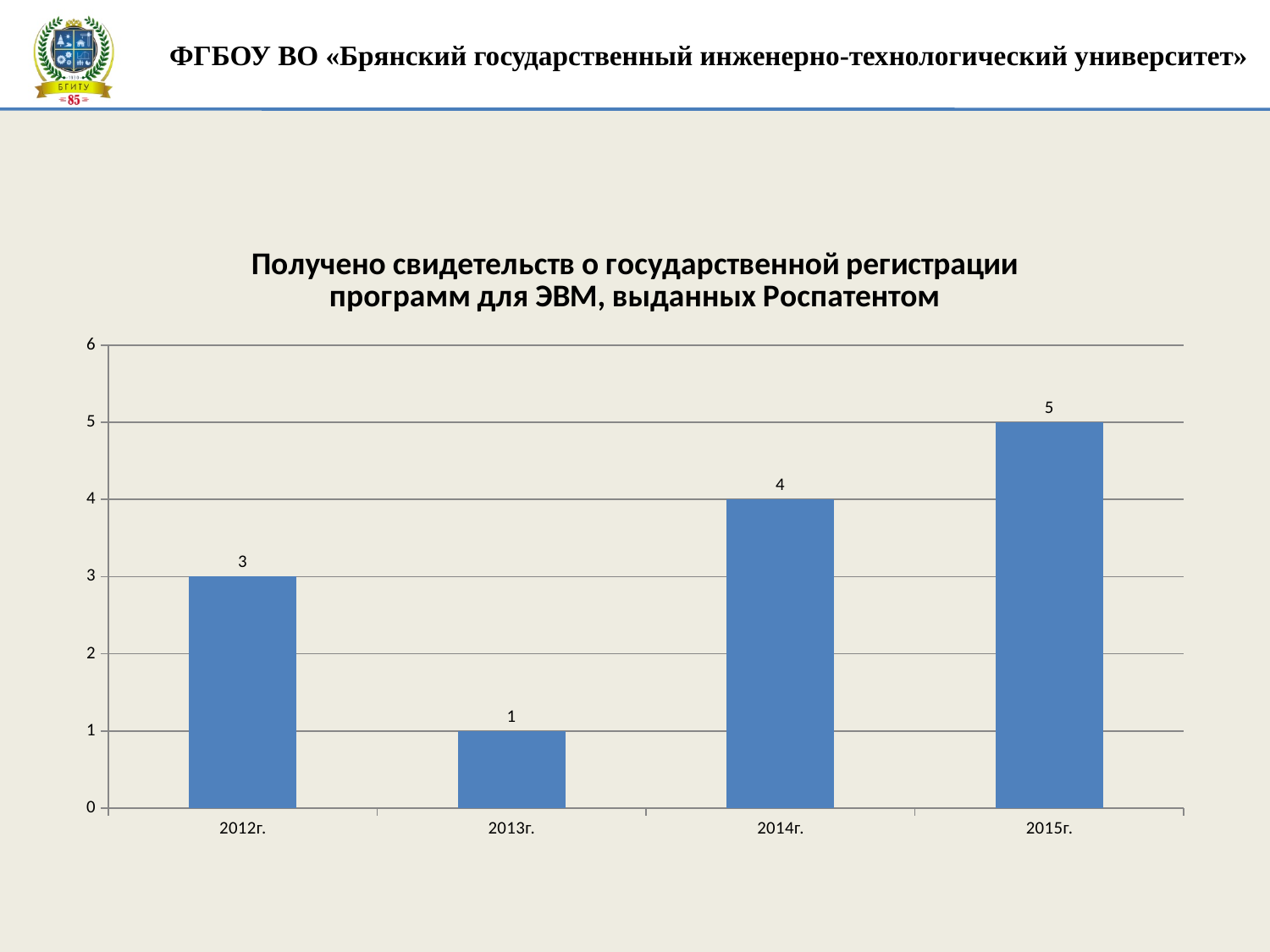
Is the value for 2015г. greater or less than 4? greater Which is larger, the value for 2014г. or the value for 2013г.? 2014г. What kind of chart is shown on the slide? bar chart What is the title of the chart? Получено свидетельств о государственной регистрации программ для ЭВМ, выданных Роспатентом What is the value for 2012г.? 3 What is the value for 2015г.? 5 What is the value for 2014г.? 4 Which year has the highest value? 2015г. How many years are shown on the x axis? 4 What is the difference between the values for 2015г. and 2012г.? 2 What is the value for 2013г.? 1 Which year has the lowest value? 2013г.